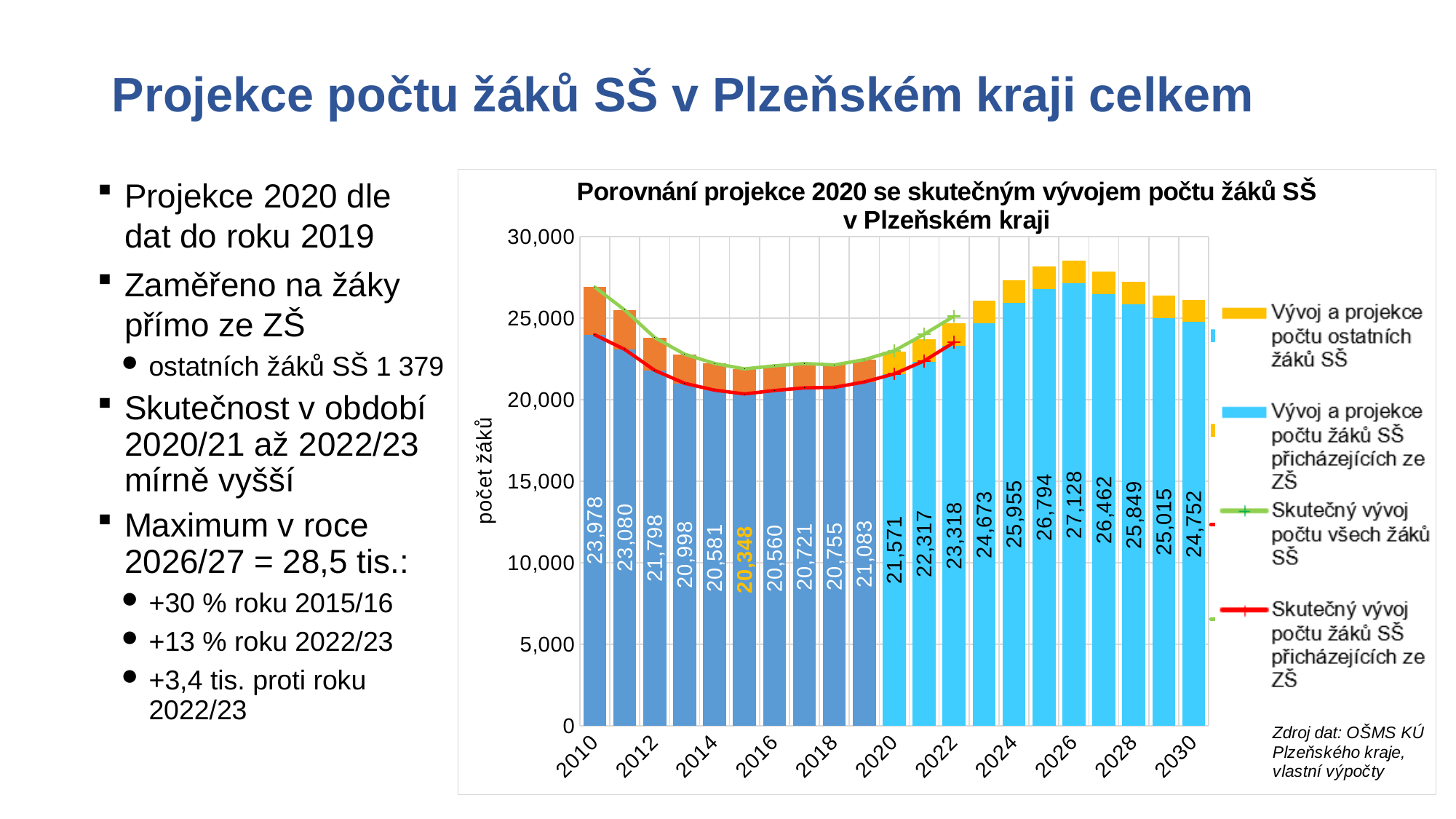
What is the labelled value for 2020 for the number of SŠ pupils coming from ZŠ? 21,571 What is the labelled value for 2026 for the number of SŠ pupils coming from ZŠ? 27,128 Is the total height of the stacked bar for 2026 greater or less than 25,000? greater How many years (bars) are shown on the x axis of the chart? 21 Do the labelled values for SŠ pupils coming from ZŠ rise or fall from 2010 to 2015? fall What is the difference between the labelled values for 2026 and 2022 for SŠ pupils coming from ZŠ? 3,810 What is the difference between the labelled values for 2010 and 2011 for SŠ pupils coming from ZŠ? 898 Which year has the larger labelled value for SŠ pupils coming from ZŠ, 2010 or 2030? 2030 In which year is the labelled number of SŠ pupils coming from ZŠ the highest? 2026 In which year is the labelled number of SŠ pupils coming from ZŠ the lowest? 2015 How many series does the chart legend list? 4 What is the labelled value for 2015 for the number of SŠ pupils coming from ZŠ? 20,348